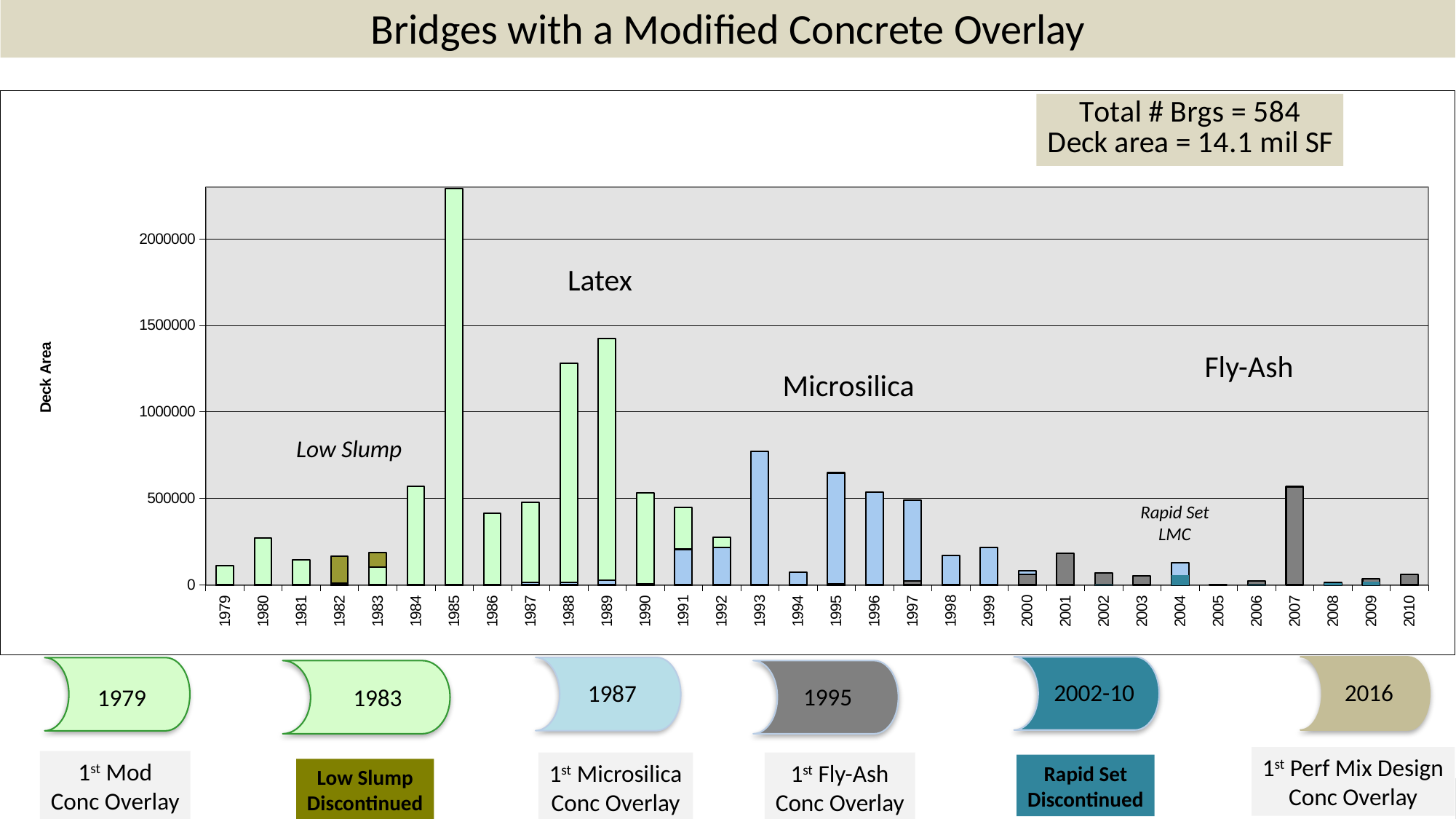
Is the deck area for 1993 greater or less than 1000000? less Is the deck area for 1988 greater or less than 1000000? greater What kind of chart is shown on the slide? bar chart What is the title of the y axis of the chart? Deck Area How many years are shown along the x axis of the chart? 32 Which year has the highest deck area in the chart? 1985 Which year has the larger deck area, 1993 or 1995? 1993 Which year has the larger deck area, 1988 or 1989? 1989 Is the deck area for 1979 greater or less than 500000? less According to the text box on the chart, what is the total number of bridges? 584